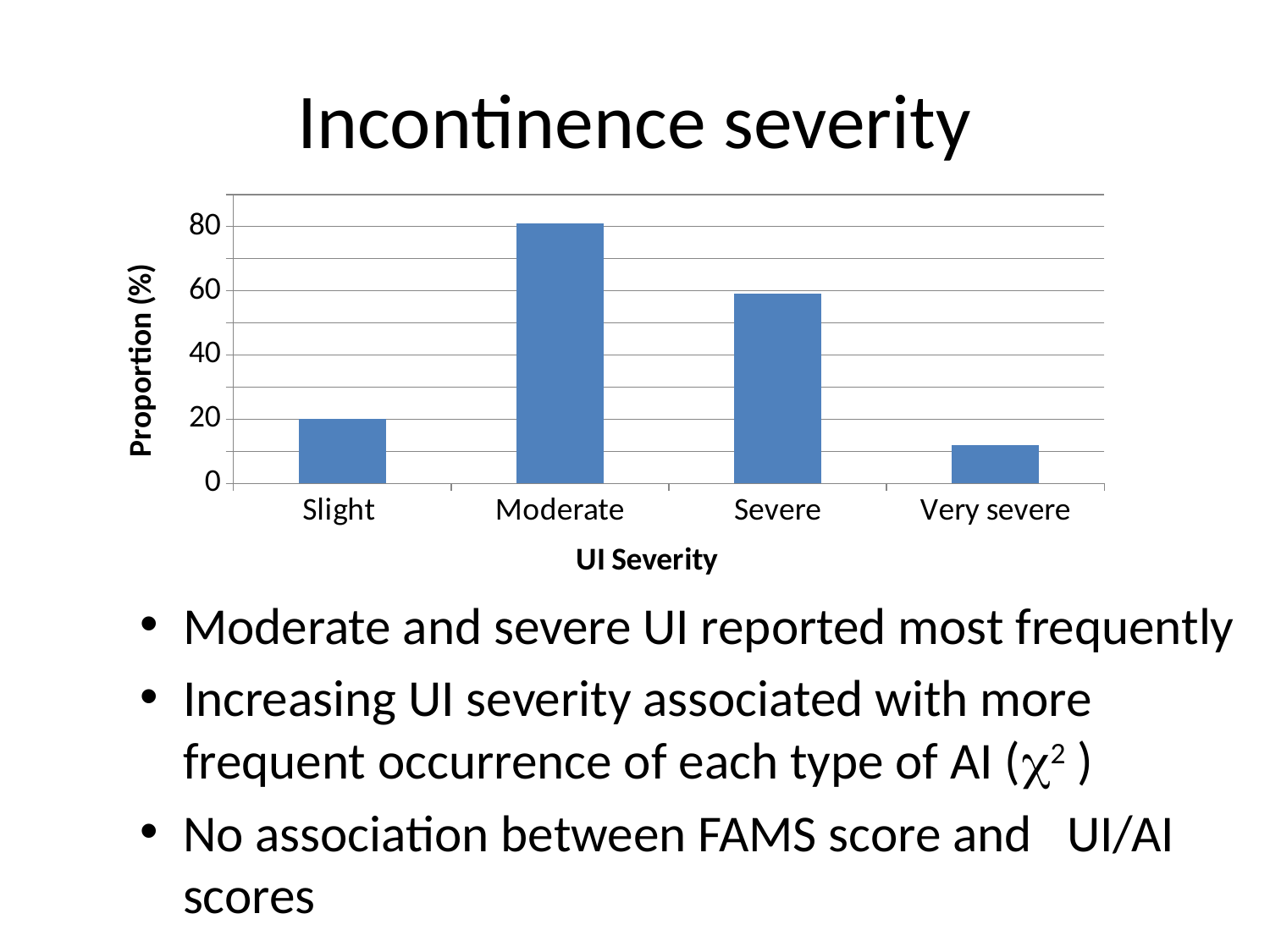
Is the value for Slight greater or less than 40? less How many UI severity categories are shown on the x axis? 4 Is the value for Very severe greater or less than 20? less Which has a larger proportion, Severe or Slight? Severe Which has a larger proportion, Moderate or Severe? Moderate What kind of chart is shown on the slide? bar chart Which UI severity category has the lowest proportion? Very severe What is the label of the x axis? UI Severity What is the label of the y axis? Proportion (%) Which UI severity category has the highest proportion? Moderate